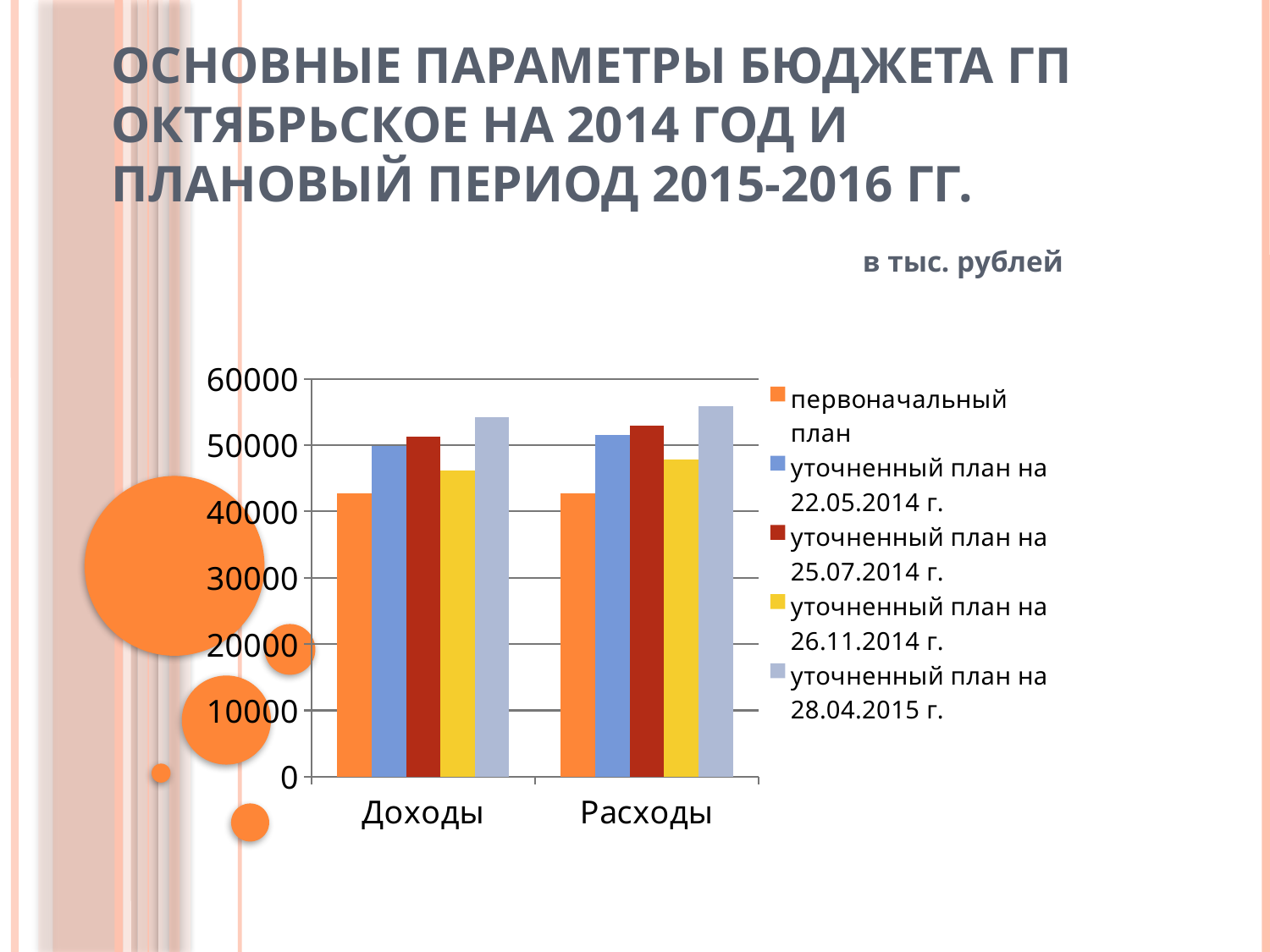
What kind of chart is shown on the slide? bar chart Is the value of уточненный план на 26.11.2014 г. for Доходы greater or less than 50000? less Which series has the highest value for Доходы? уточненный план на 28.04.2015 г. How many categories are shown on the x axis of the chart? 2 For Расходы, which is larger: уточненный план на 25.07.2014 г. or уточненный план на 26.11.2014 г.? уточненный план на 25.07.2014 г. Is the value of первоначальный план for Расходы greater or less than 50000? less What is the first series listed in the chart's legend? первоначальный план How many series does the chart's legend list? 5 In what units are the values on the chart expressed, according to the slide? в тыс. рублей Which series has the lowest value for Расходы? первоначальный план Is the value of первоначальный план for Доходы greater or less than 40000? greater